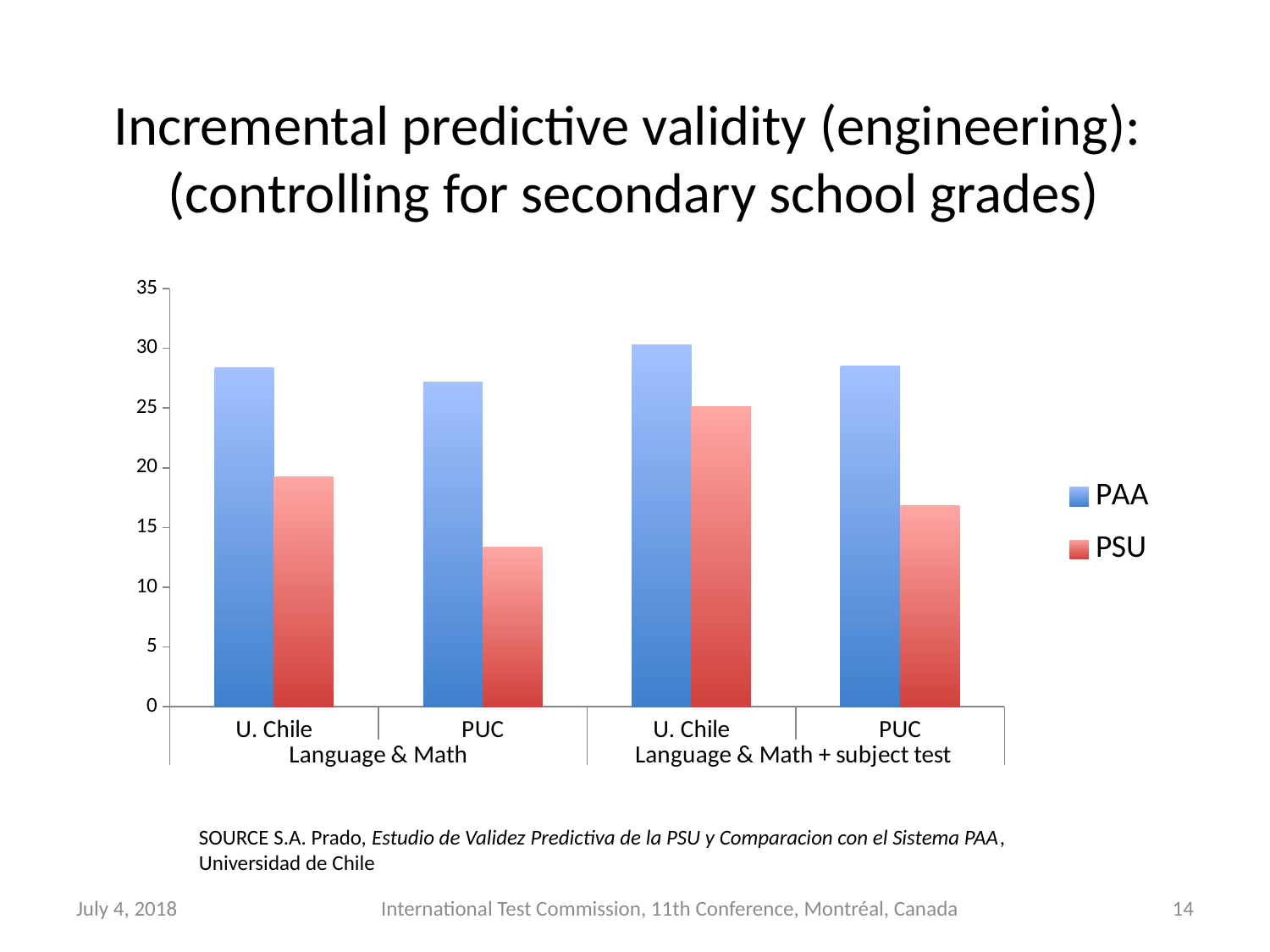
Is the PAA value for U. Chile under Language & Math + subject test greater or less than 25? greater For which category is the PSU value highest? U. Chile, Language & Math + subject test Which two series are listed in the legend? PAA and PSU For which category is the PSU value lowest? PUC, Language & Math For which category is the PAA value highest? U. Chile, Language & Math + subject test Is the PSU value for U. Chile under Language & Math + subject test greater or less than 20? greater How many category groups (pairs of bars) are plotted on the x axis? 4 Which is larger, the PSU value for U. Chile under Language & Math or the PSU value for PUC under Language & Math? U. Chile Is the PSU value for PUC under Language & Math greater or less than 15? less For U. Chile under Language & Math, which is larger, the PAA value or the PSU value? PAA How many series does the legend list? 2 What kind of chart is shown on the slide? bar chart